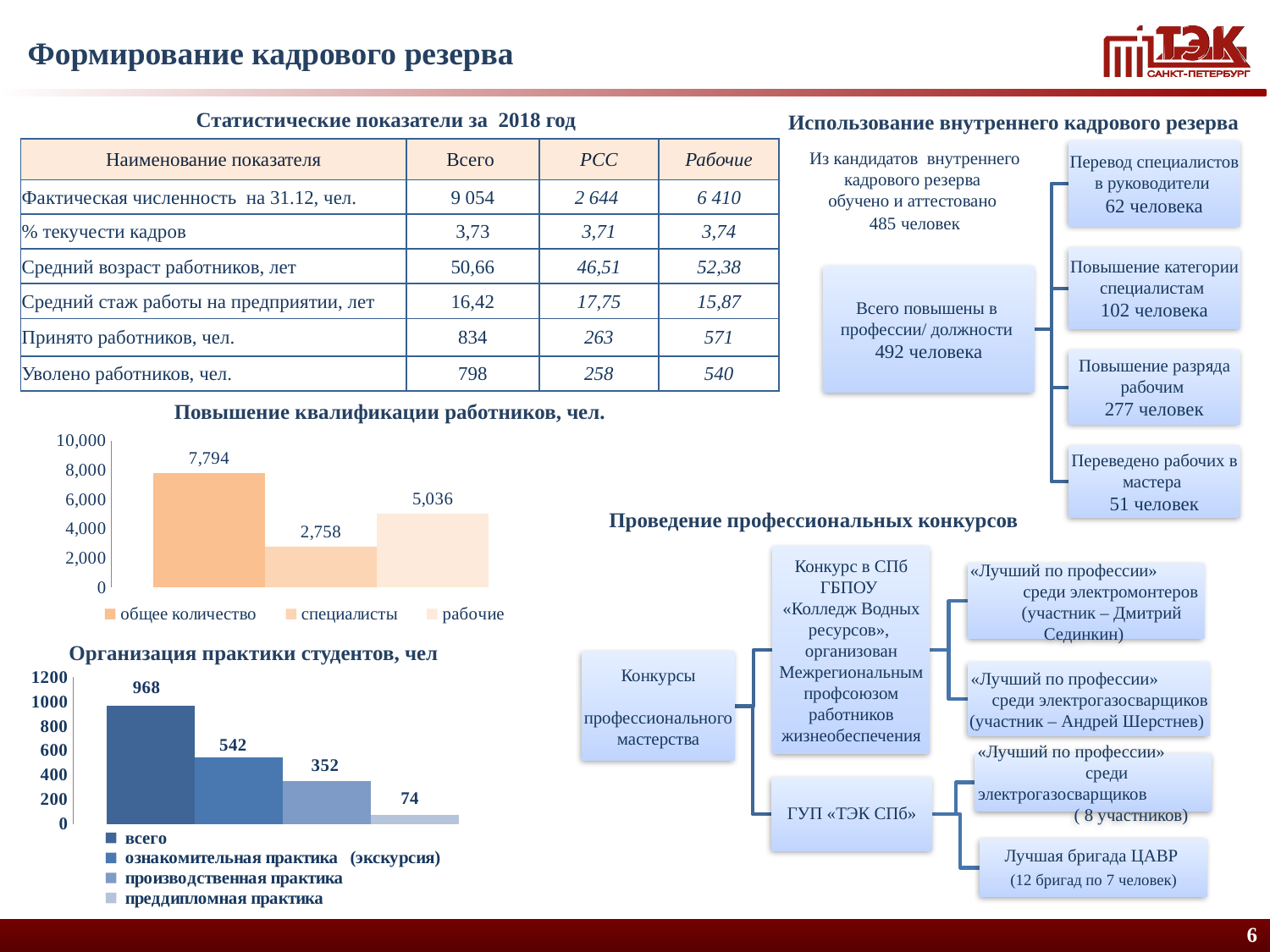
In the chart 'Повышение квалификации работников, чел.', what is the value for 'рабочие'? 5,036 In the chart 'Организация практики студентов, чел', what is the value for 'производственная практика'? 352 What kind of chart is 'Организация практики студентов, чел'? bar chart In the chart 'Повышение квалификации работников, чел.', what is the value for 'общее количество'? 7,794 In the chart 'Организация практики студентов, чел', which series has the lowest value? преддипломная практика How many series does the legend of the chart 'Повышение квалификации работников, чел.' list? 3 In the chart 'Повышение квалификации работников, чел.', which series has the lowest value? специалисты In the chart 'Повышение квалификации работников, чел.', what is the value for 'специалисты'? 2,758 In the chart 'Организация практики студентов, чел', what is the difference between 'ознакомительная практика (экскурсия)' and 'производственная практика'? 190 In the chart 'Организация практики студентов, чел', what is the value for 'всего'? 968 In the chart 'Организация практики студентов, чел', which is larger: 'ознакомительная практика (экскурсия)' or 'преддипломная практика'? ознакомительная практика (экскурсия) In the chart 'Повышение квалификации работников, чел.', what is the difference between 'рабочие' and 'специалисты'? 2,278